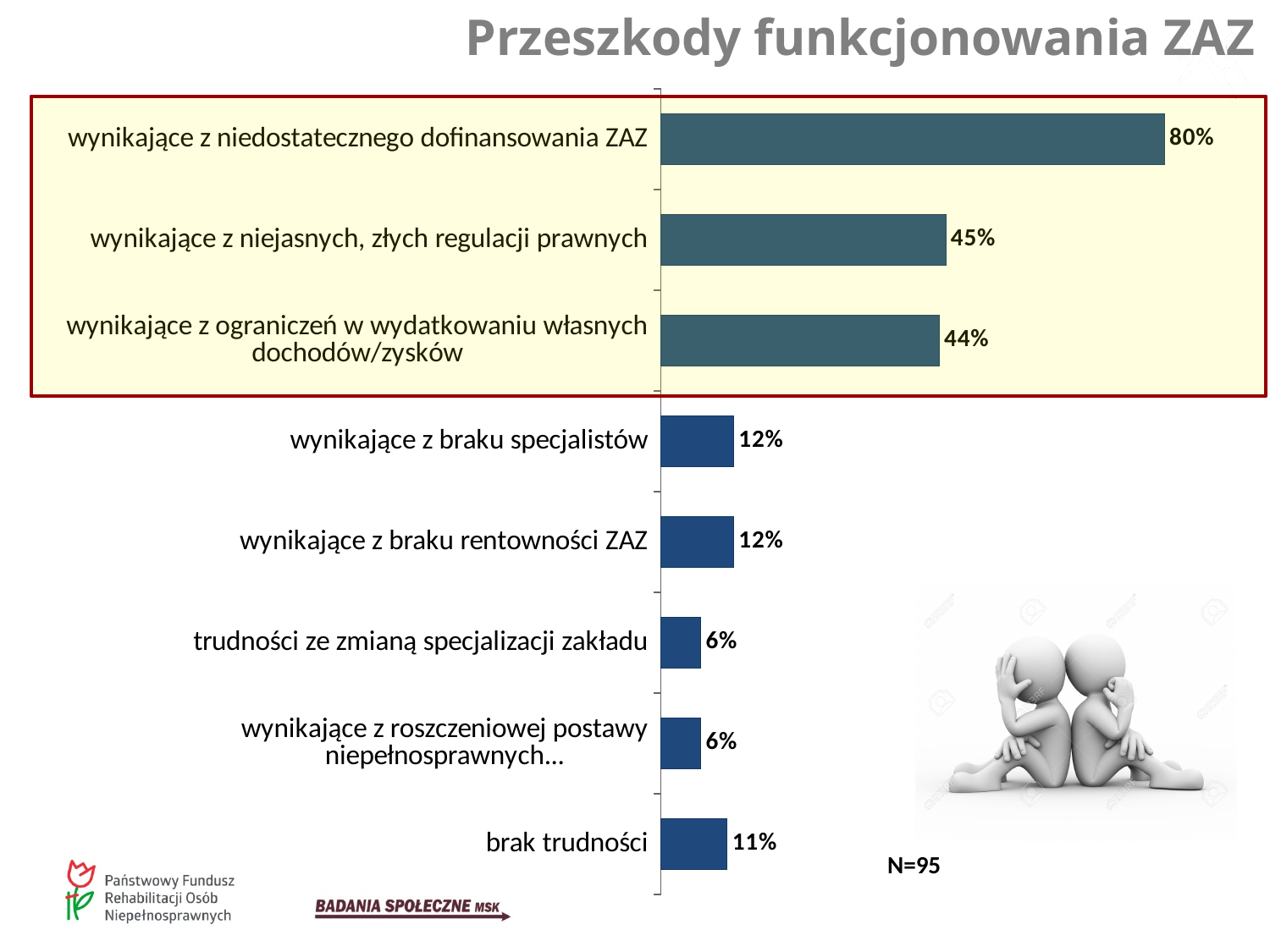
What is the difference between the values for "wynikające z niedostatecznego dofinansowania ZAZ" and "wynikające z niejasnych, złych regulacji prawnych"? 35% What sample size (N) is shown on the slide? N=95 Which category has the highest value? wynikające z niedostatecznego dofinansowania ZAZ What is the difference between the values for "wynikające z braku specjalistów" and "brak trudności"? 1% What is the value for "wynikające z niedostatecznego dofinansowania ZAZ"? 80% What is the value for "brak trudności"? 11% What is the title of the slide? Przeszkody funkcjonowania ZAZ What is the value for "trudności ze zmianą specjalizacji zakładu"? 6% What is the value for "wynikające z niejasnych, złych regulacji prawnych"? 45% How many categories are shown in the chart? 8 What kind of chart is shown on the slide? bar chart Which is larger: the value for "wynikające z ograniczeń w wydatkowaniu własnych dochodów/zysków" or the value for "wynikające z braku rentowności ZAZ"? wynikające z ograniczeń w wydatkowaniu własnych dochodów/zysków